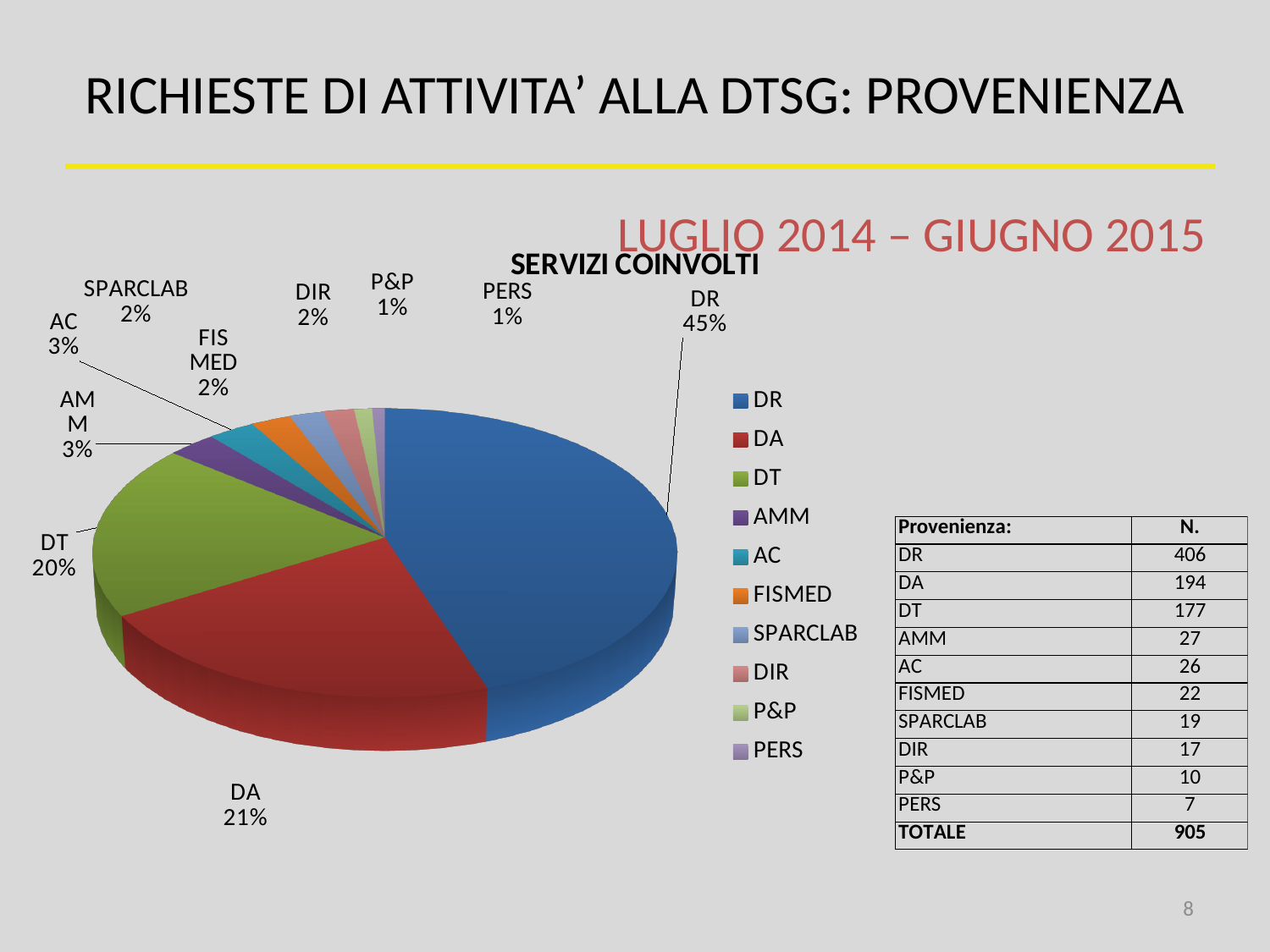
What percentage is shown for PERS? 1% What share of the pie does DT represent? 20% Which is larger, the share for DT or the share for AC? DT What is the title of the chart? SERVIZI COINVOLTI What is the difference in percentage points between DR and DA? 24 Which category has the largest slice of the pie? DR What percentage is shown for AMM? 3% What share of the pie does DR represent? 45% What share of the pie does DA represent? 21% What kind of chart is shown on the slide? pie chart What colour is the DR slice in the pie chart? blue How many categories does the legend list? 10